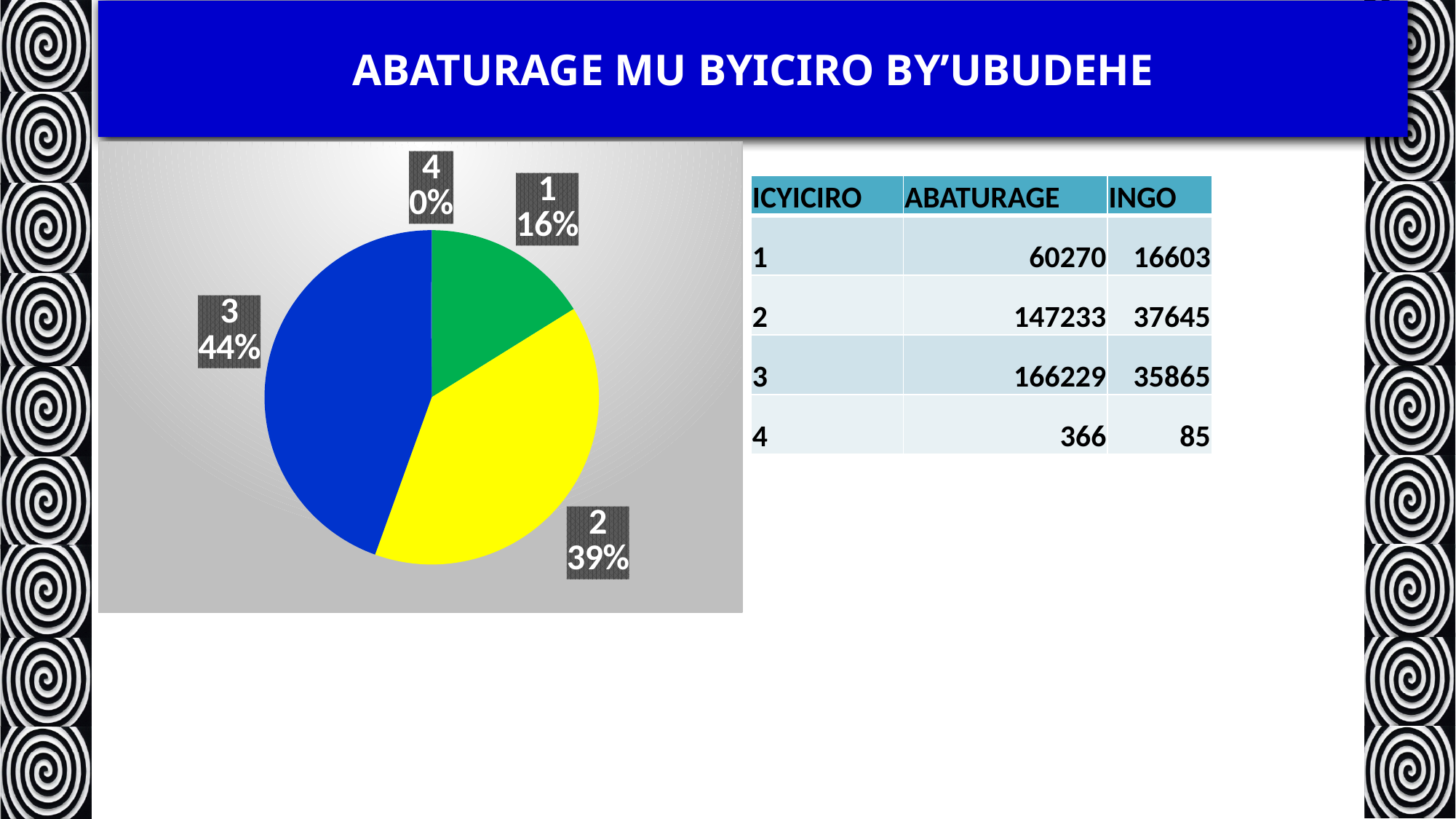
Which category has the smallest share of the pie? 4 Which category has the largest share of the pie? 3 What share of the pie does category 4 have? 0% What share of the pie does category 2 have? 39% What colour is the slice for category 3 in the pie chart? blue What is the difference in percentage points between the shares of category 3 and category 2? 5% What kind of chart is shown on the slide? pie chart What colour is the slice for category 1 in the pie chart? green What share of the pie does category 1 have? 16% Which has a larger share of the pie, category 1 or category 2? 2 How many categories are shown in the pie chart? 4